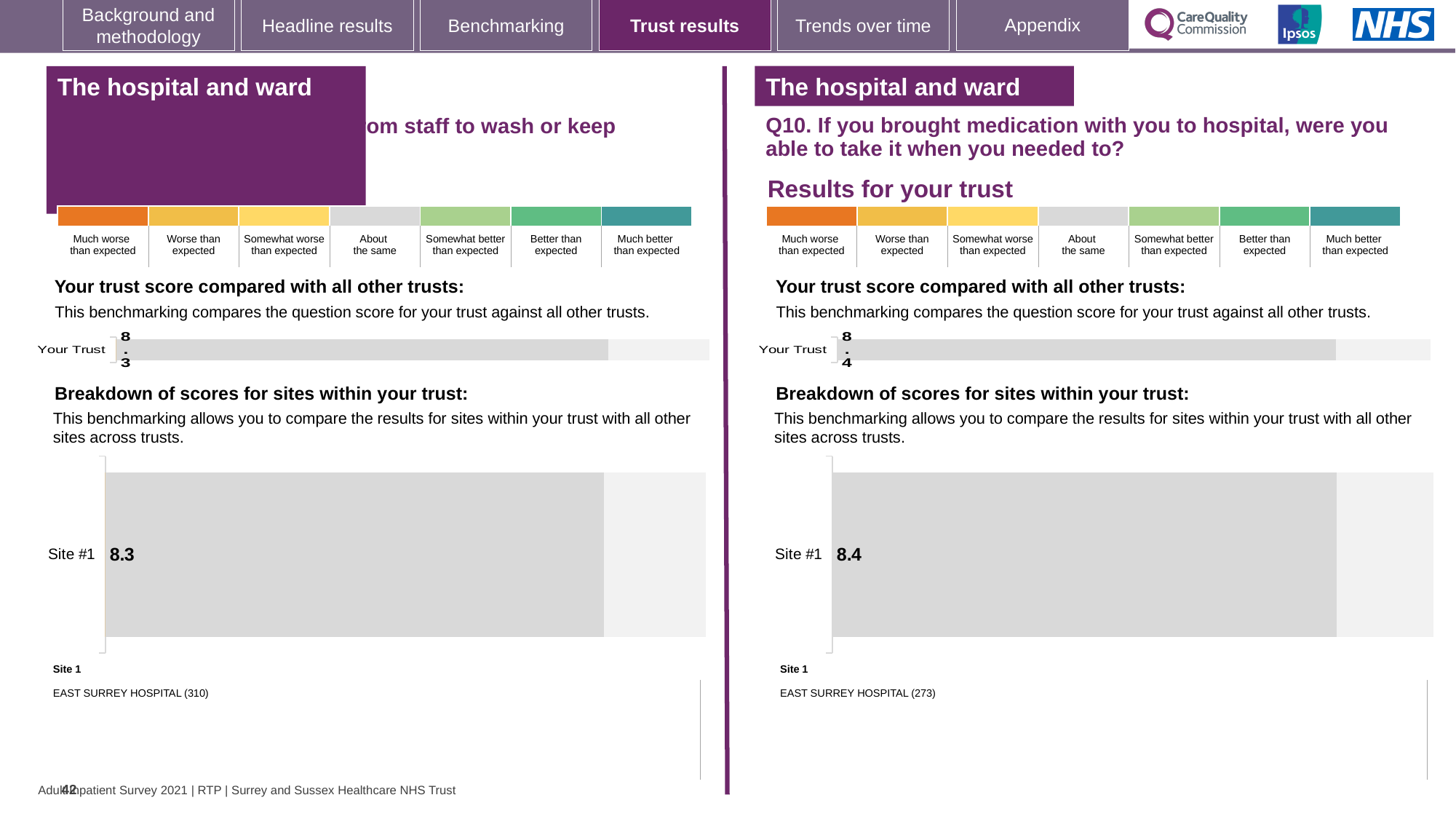
In the left-hand 'Breakdown of scores for sites within your trust' chart, what is the score for Site #1? 8.3 On the right half of the slide (Q10), what is the score shown for Your Trust in the 'Your trust score compared with all other trusts' chart? 8.4 What type of chart is used to show the Site #1 score on the right half of the slide (Q10)? Bar chart On the left half of the slide, what is the score shown for Your Trust in the 'Your trust score compared with all other trusts' chart? 8.3 How many sites are plotted in the left-hand 'Breakdown of scores for sites within your trust' chart? 1 Which hospital is listed as Site 1 beneath the right-hand site breakdown chart (Q10)? EAST SURREY HOSPITAL (273) Which hospital is listed as Site 1 beneath the left-hand site breakdown chart? EAST SURREY HOSPITAL (310) Which is larger: the Your Trust score on the left half of the slide or the Your Trust score on the right half (Q10)? The right half (Q10), 8.4 In the right-hand 'Breakdown of scores for sites within your trust' chart (Q10), what is the score for Site #1? 8.4 What is the difference between the Site #1 score on the right half of the slide (Q10) and the Site #1 score on the left half? 0.1 How many sites are plotted in the right-hand 'Breakdown of scores for sites within your trust' chart (Q10)? 1